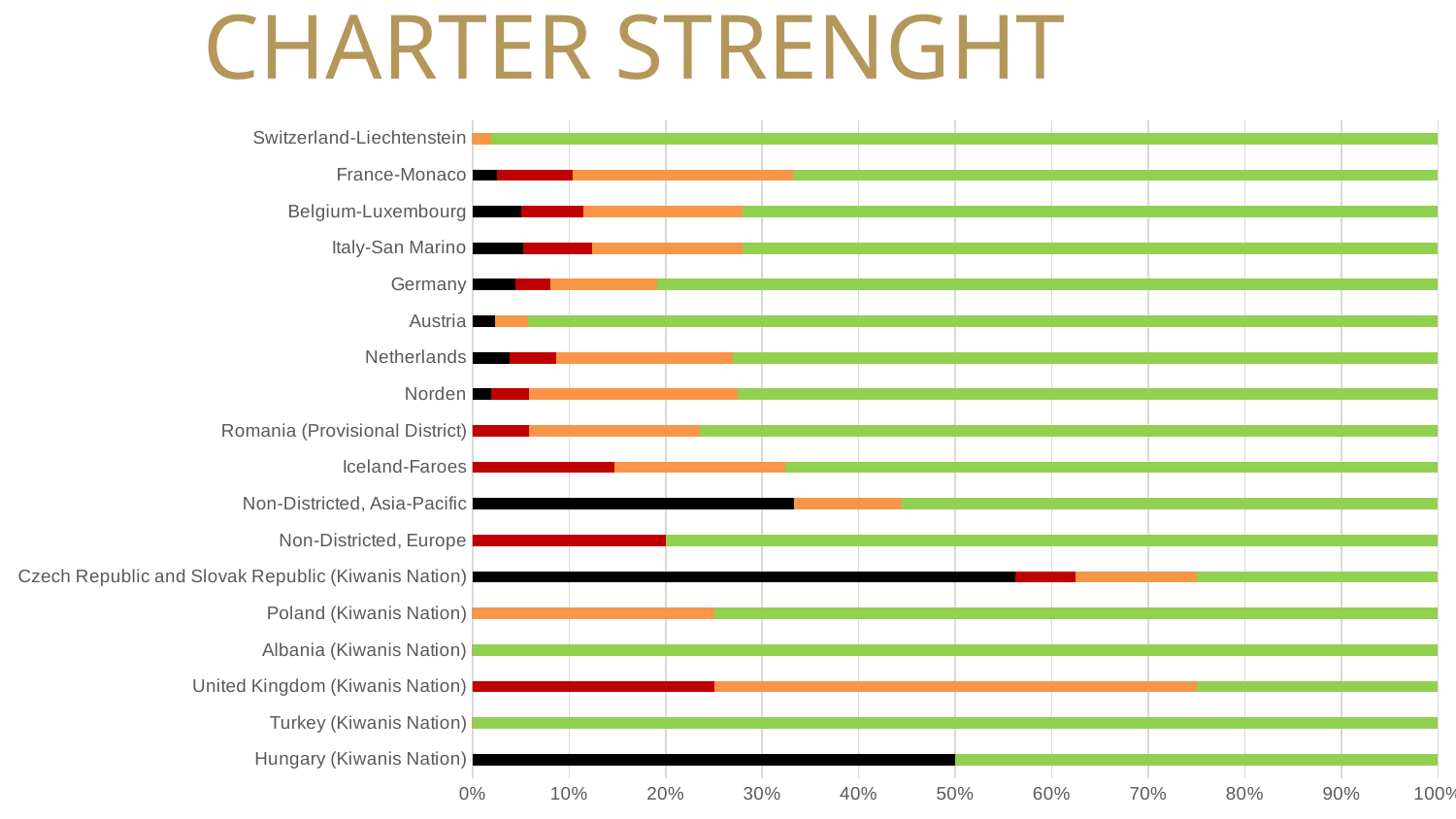
How many different segment colours are used in the bars? 4 Is the green segment for Switzerland-Liechtenstein greater or less than 90%? greater Which category has the longest black segment? Czech Republic and Slovak Republic (Kiwanis Nation) Is the black segment for Czech Republic and Slovak Republic (Kiwanis Nation) greater or less than 50%? greater Is the dark red segment for Non-Districted, Europe greater or less than 10%? greater Which has the larger black segment, Hungary (Kiwanis Nation) or Non-Districted, Asia-Pacific? Hungary (Kiwanis Nation) What is the title of the chart? CHARTER STRENGHT How many categories are listed on the vertical axis of the chart? 18 What kind of chart is shown on the slide? bar chart